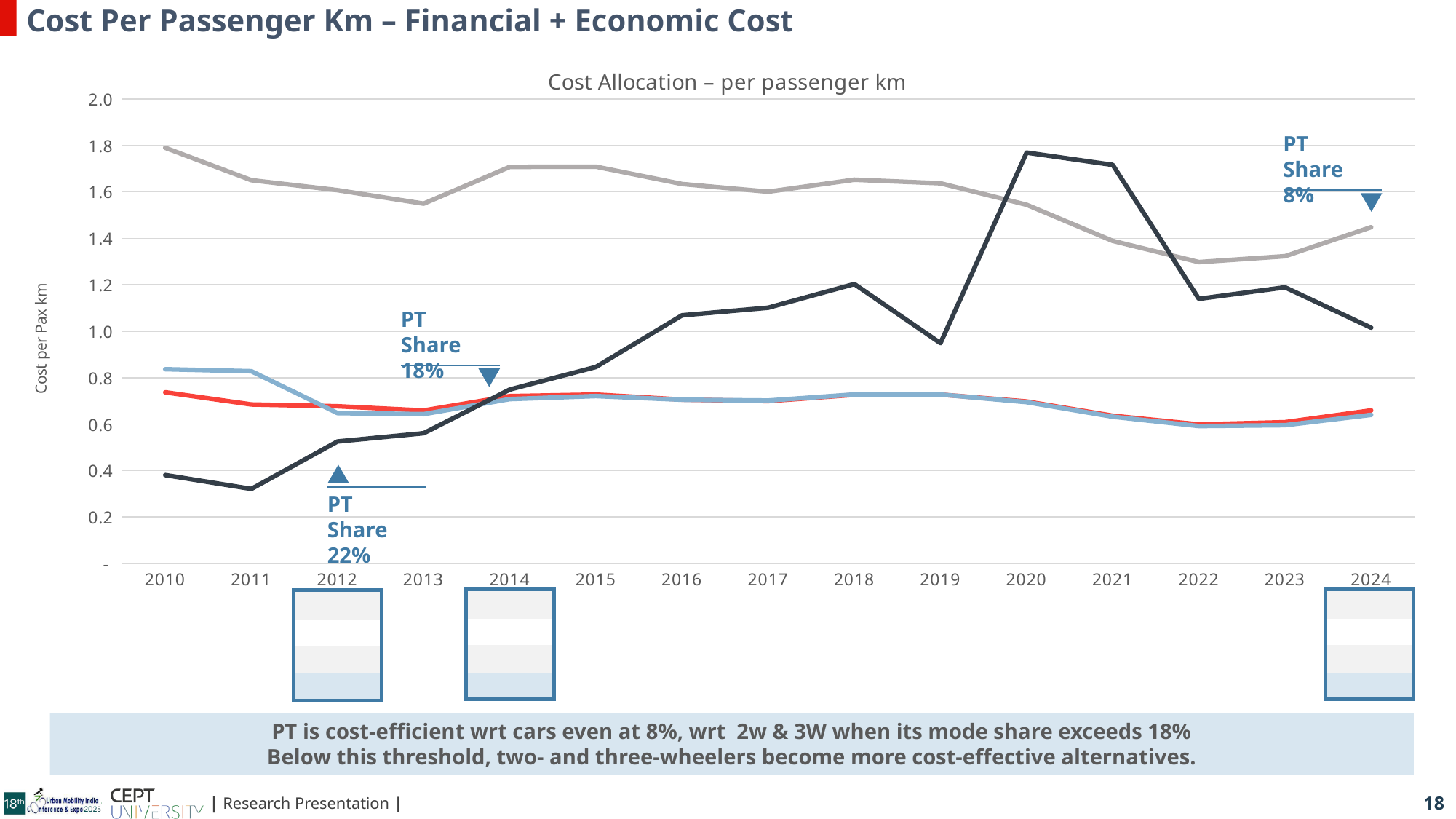
What is the title of the chart? Cost Allocation – per passenger km How many years are shown along the x axis of the chart? 15 Is the value of the gray line in 2022 greater or less than 1.4? less In 2020, which line has the higher value, the gray line or the dark navy line? Dark navy line In which year does the dark navy line reach its lowest value? 2011 In which year does the dark navy line reach its highest value? 2020 Is the value of the dark navy line in 2011 greater or less than 0.4? less What PT share is annotated at 2024 on the chart? 8% Is the value of the gray line in 2010 greater or less than 1.6? greater Does the dark navy line rise or fall between 2011 and 2018? Rise What kind of chart is shown on the slide? Line chart